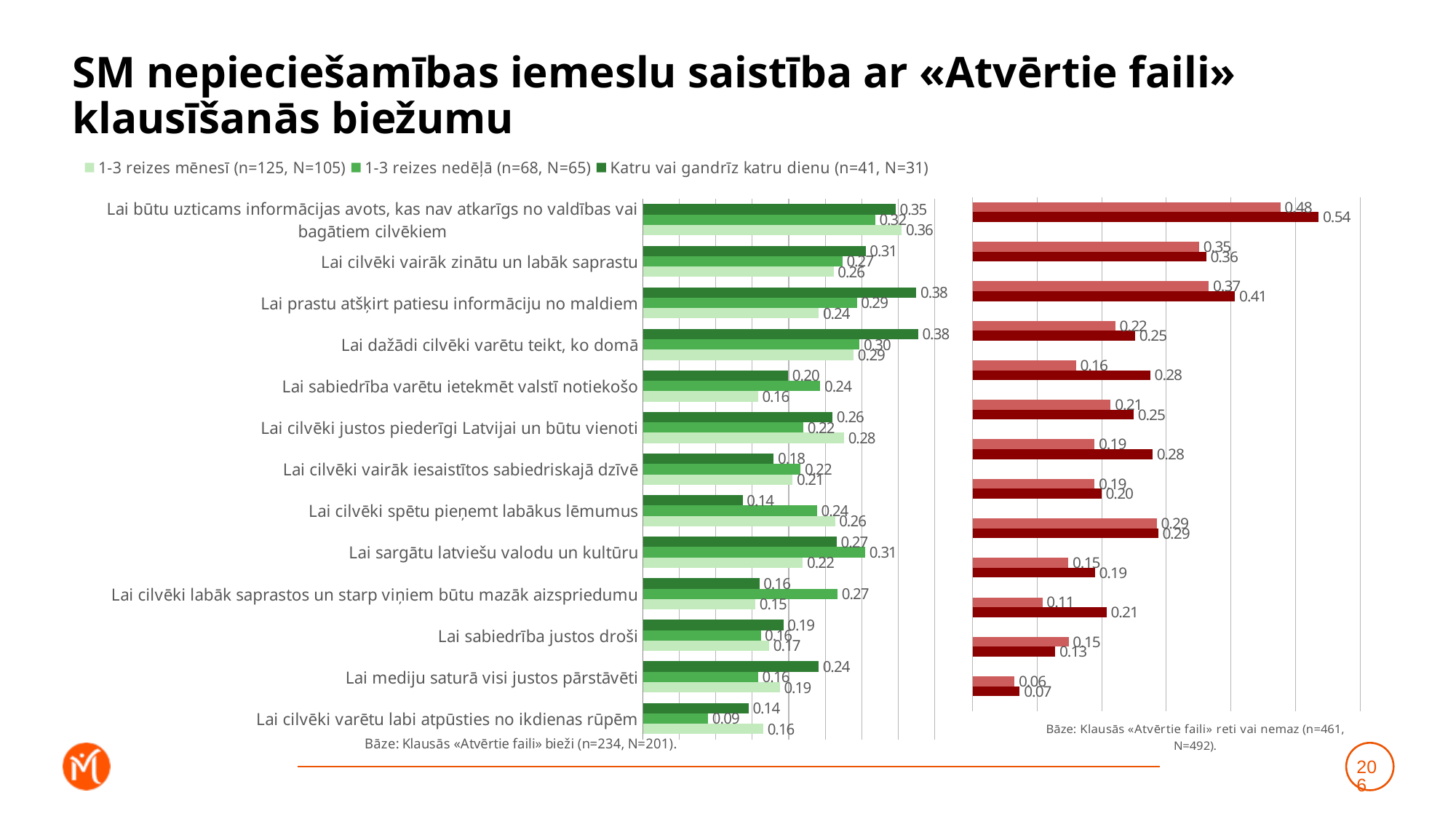
In the left (green) chart, what is the value for 'Lai cilvēki varētu labi atpūsties no ikdienas rūpēm' in the '1-3 reizes mēnesī' series? 0.16 In the left (green) chart, what is the value for 'Lai prastu atšķirt patiesu informāciju no maldiem' in the 'Katru vai gandrīz katru dienu' series? 0.38 How many categories are shown in the left (green) chart? 13 What kind of chart is the left (green) chart? Bar chart In the right (red) chart, what is the value of the darker red bar for 'Lai būtu uzticams informācijas avots, kas nav atkarīgs no valdības vai bagātiem cilvēkiem'? 0.54 In the left (green) chart, which category has the lowest value in the '1-3 reizes nedēļā' series? Lai cilvēki varētu labi atpūsties no ikdienas rūpēm In the left (green) chart, what is the value for 'Lai sargātu latviešu valodu un kultūru' in the '1-3 reizes nedēļā' series? 0.31 In the left (green) chart, what is the difference between the 'Katru vai gandrīz katru dienu' and '1-3 reizes mēnesī' values for 'Lai prastu atšķirt patiesu informāciju no maldiem'? 0.14 Which series in the left (green) chart's legend has the sample size 'n=41, N=31'? Katru vai gandrīz katru dienu In the right (red) chart, what is the difference between the darker red bar and the lighter red bar for 'Lai sabiedrība varētu ietekmēt valstī notiekošo'? 0.12 How many series does the legend of the left (green) chart list? 3 In the left (green) chart, for 'Lai cilvēki spētu pieņemt labākus lēmumus', which series has the larger value: '1-3 reizes mēnesī' or 'Katru vai gandrīz katru dienu'? 1-3 reizes mēnesī